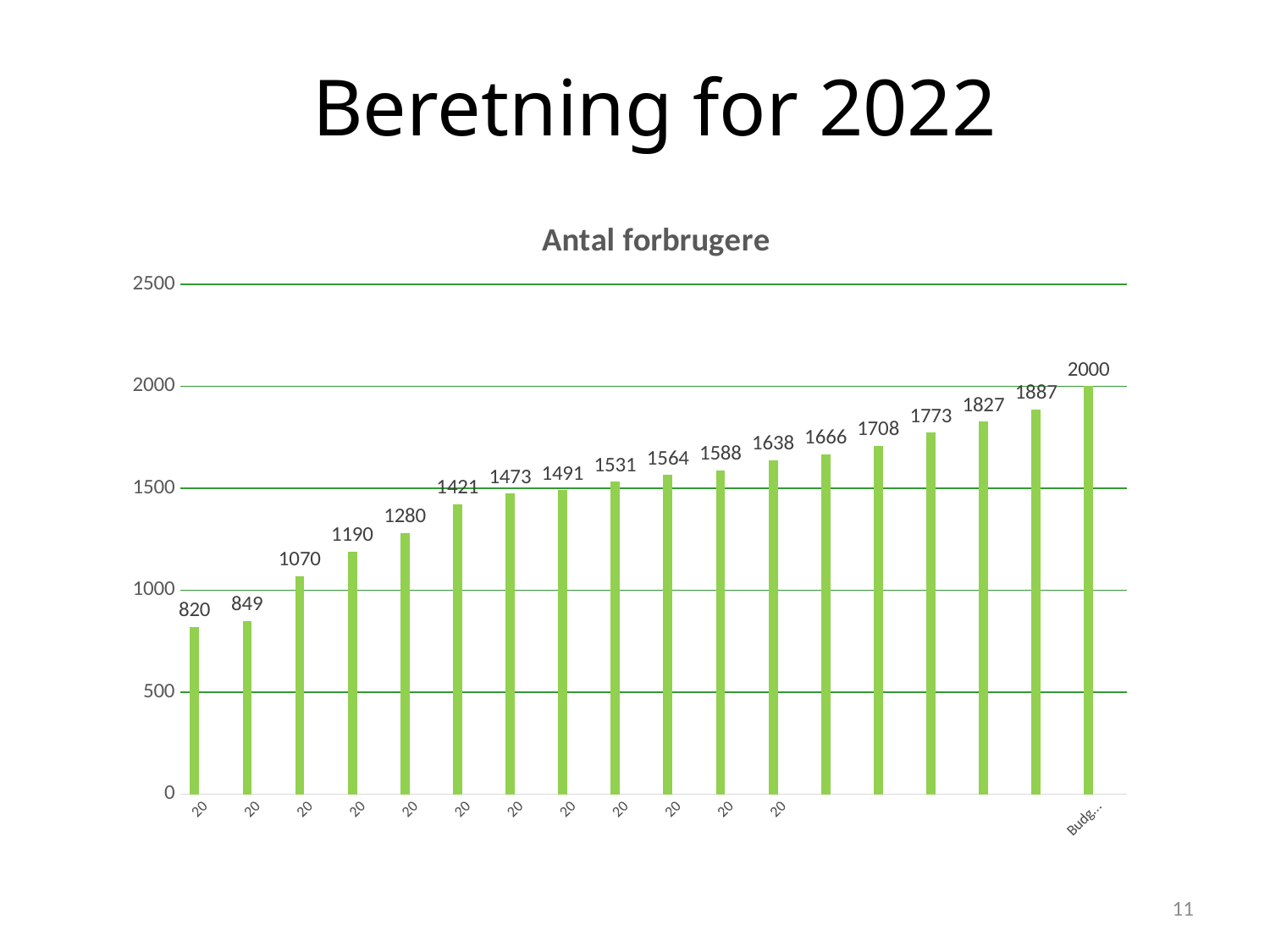
What is the value of the second bar from the left in the chart? 849 What colour are the bars in the chart? green What is the value of the first (leftmost) bar in the chart? 820 What is the difference between the rightmost bar (2000) and the leftmost bar (820)? 1180 What is the highest value shown in the chart? 2000 What is the lowest value shown in the chart? 820 How many bars are plotted in the chart? 18 Is the value of the leftmost bar greater or less than 1000? less What is the value of the last (rightmost) bar in the chart? 2000 What is the title of the chart? Antal forbrugere Do the values generally rise or fall from left to right along the x axis? rise What kind of chart is shown on the slide? bar chart